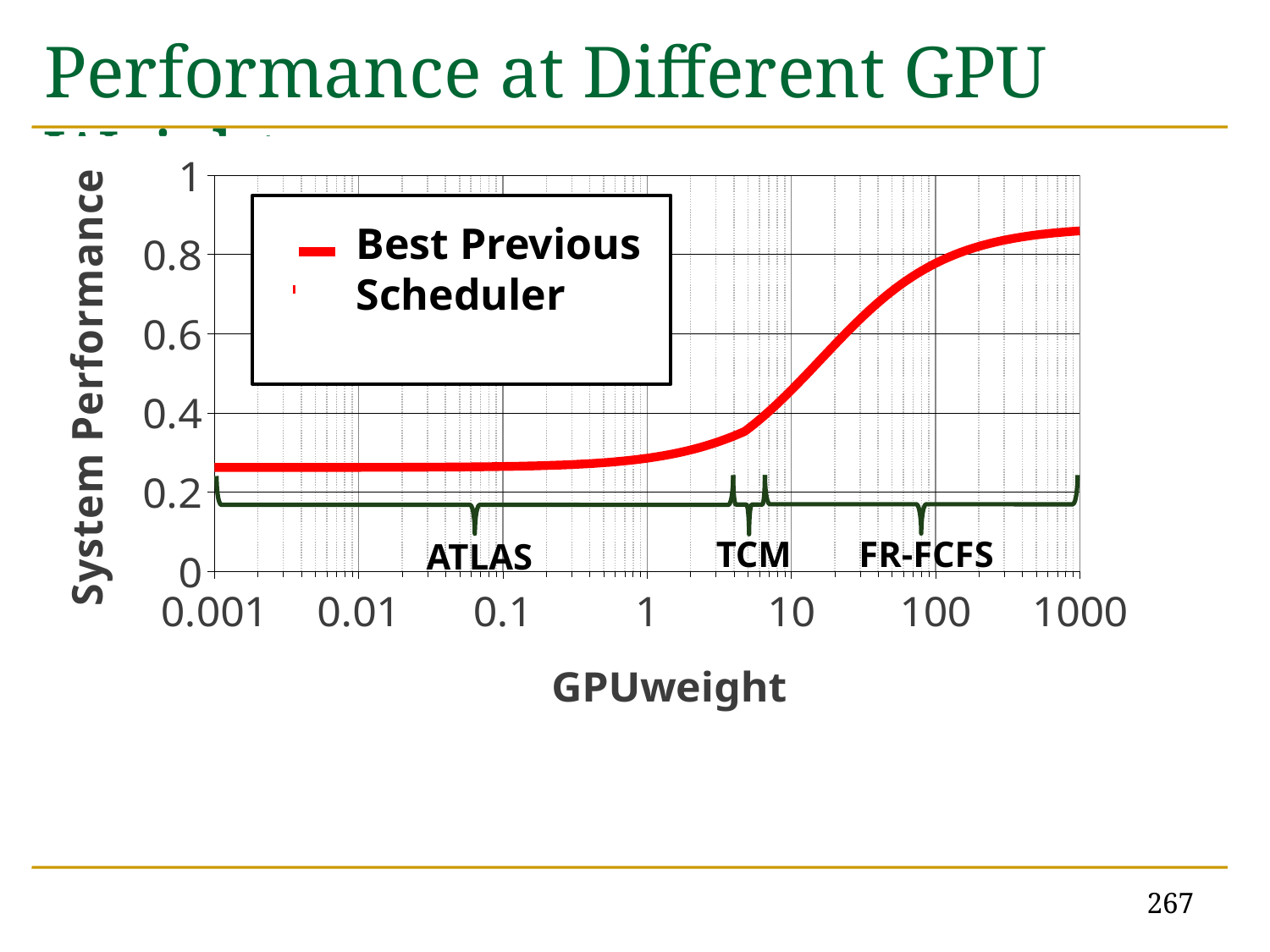
What is the label of the x axis? GPUweight Which has the larger System Performance value: GPUweight 0.001 or GPUweight 1000? GPUweight 1000 Is the System Performance value at GPUweight 1000 greater or less than 0.8? greater How many series does the legend list? 1 What kind of chart is shown on the slide? line chart What is the name of the series shown in the legend? Best Previous Scheduler Which has the larger System Performance value: GPUweight 1 or GPUweight 100? GPUweight 100 Is the System Performance value at GPUweight 1 greater or less than 0.4? less Is the System Performance value at GPUweight 0.001 greater or less than 0.4? less Does System Performance rise or fall as GPUweight increases along the x axis? rise